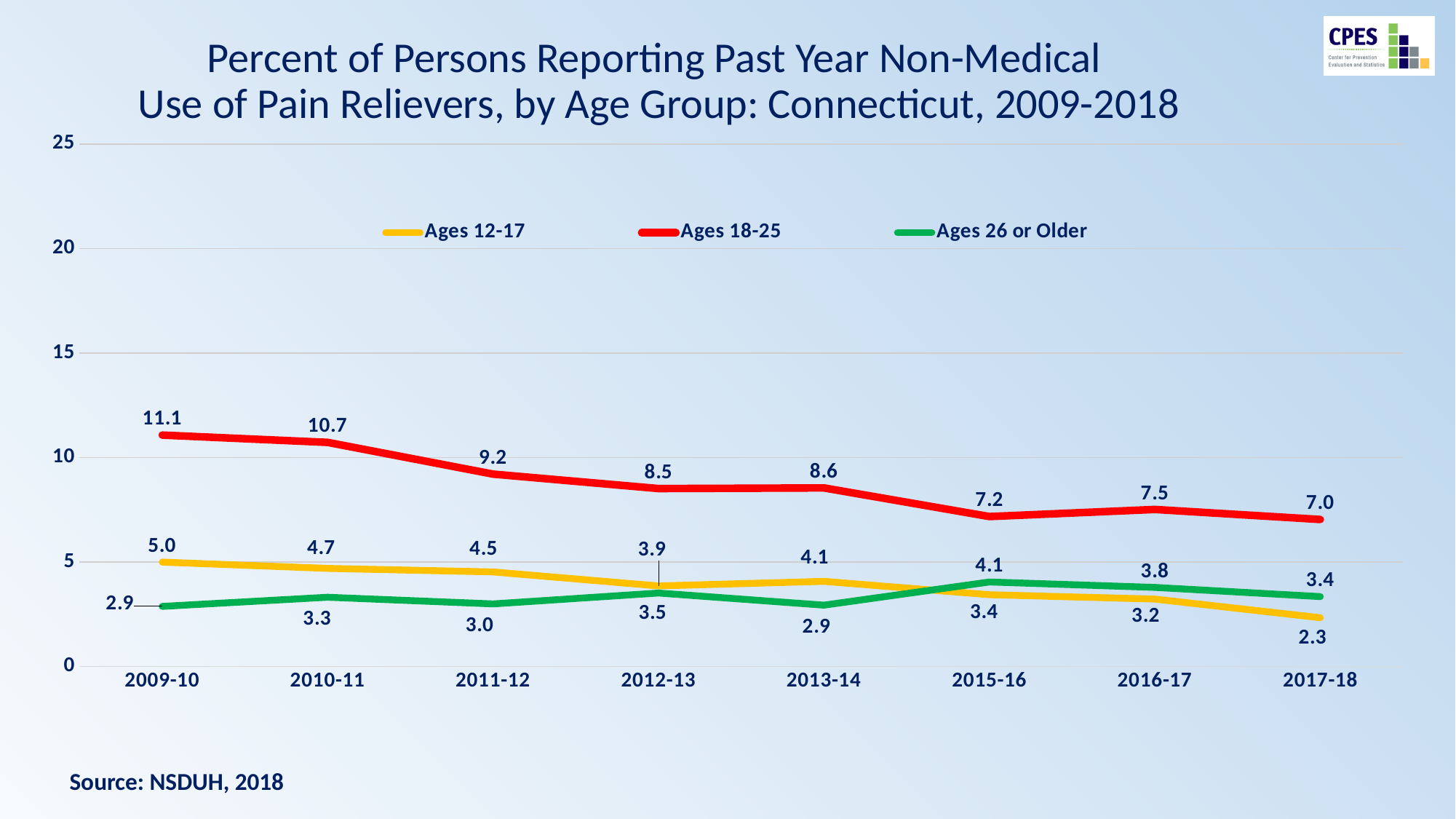
What is the value for Ages 26 or Older in 2015-16? 4.1 What is the value for Ages 18-25 in 2009-10? 11.1 In which period is the value for Ages 12-17 lowest? 2017-18 What is the value for Ages 12-17 in 2017-18? 2.3 How many time periods are shown on the x axis? 8 What kind of chart is shown on the slide? line chart Is the value for Ages 18-25 in 2011-12 greater or less than 10? less In which period is the value for Ages 18-25 highest? 2009-10 Does the value for Ages 12-17 rise or fall from 2009-10 to 2017-18? fall What is the difference between the Ages 18-25 values in 2009-10 and 2017-18? 4.1 How many series does the legend list? 3 Which is larger in 2015-16, the value for Ages 12-17 or Ages 26 or Older? Ages 26 or Older